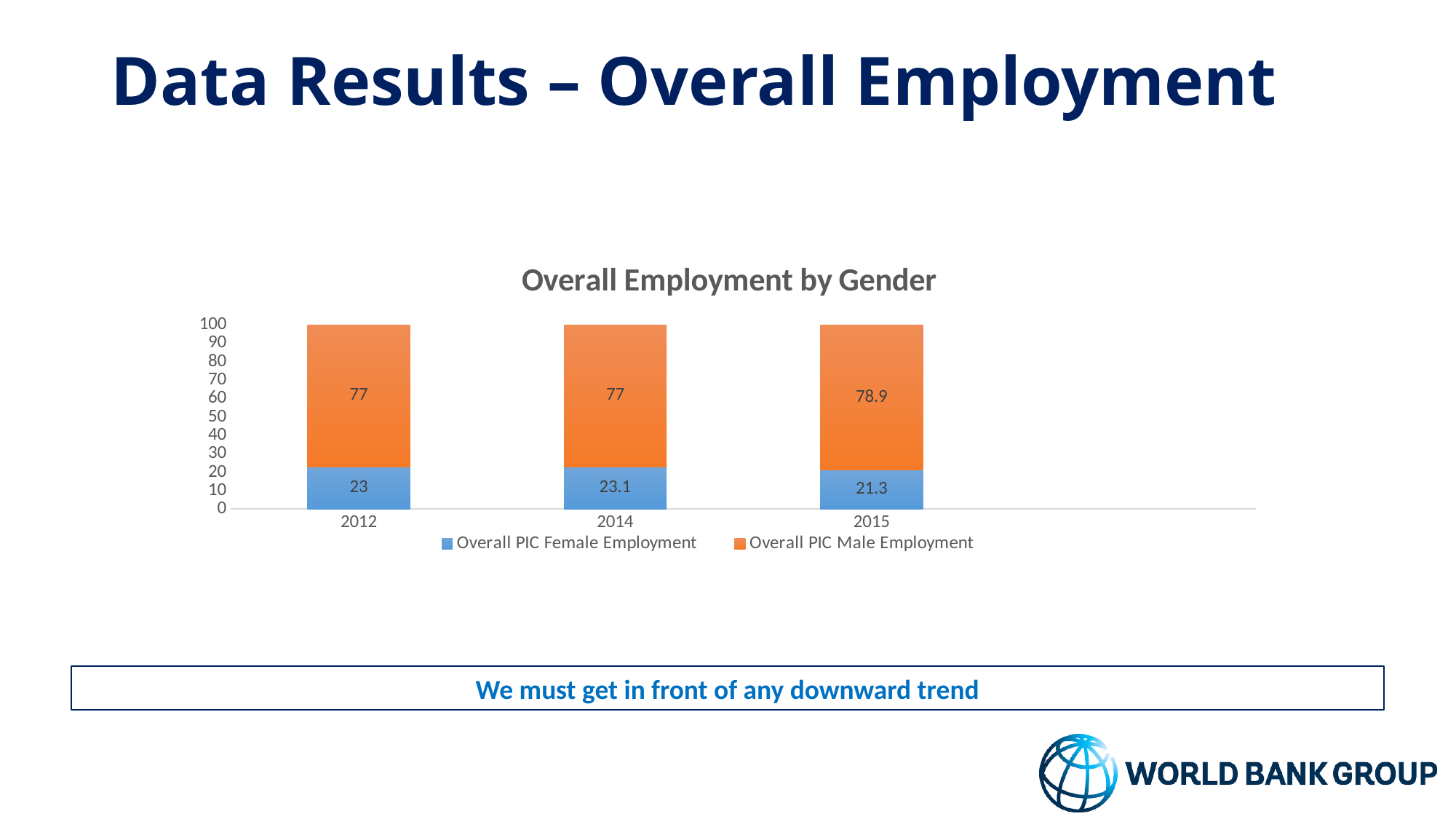
What is the Overall PIC Female Employment value for 2012? 23 What is the Overall PIC Male Employment value for 2015? 78.9 Which year has the highest Overall PIC Male Employment value? 2015 Is the Overall PIC Female Employment value for 2014 larger or smaller than the value for 2015? larger How many series does the legend list? 2 What is the total of the stacked bar for 2015? 100.2 What kind of chart is shown on the slide? stacked bar chart What is the title of the chart? Overall Employment by Gender How many years are shown on the x axis? 3 What is the Overall PIC Female Employment value for 2014? 23.1 What is the difference between the Overall PIC Male Employment values for 2015 and 2014? 1.9 Which year has the lowest Overall PIC Female Employment value? 2015